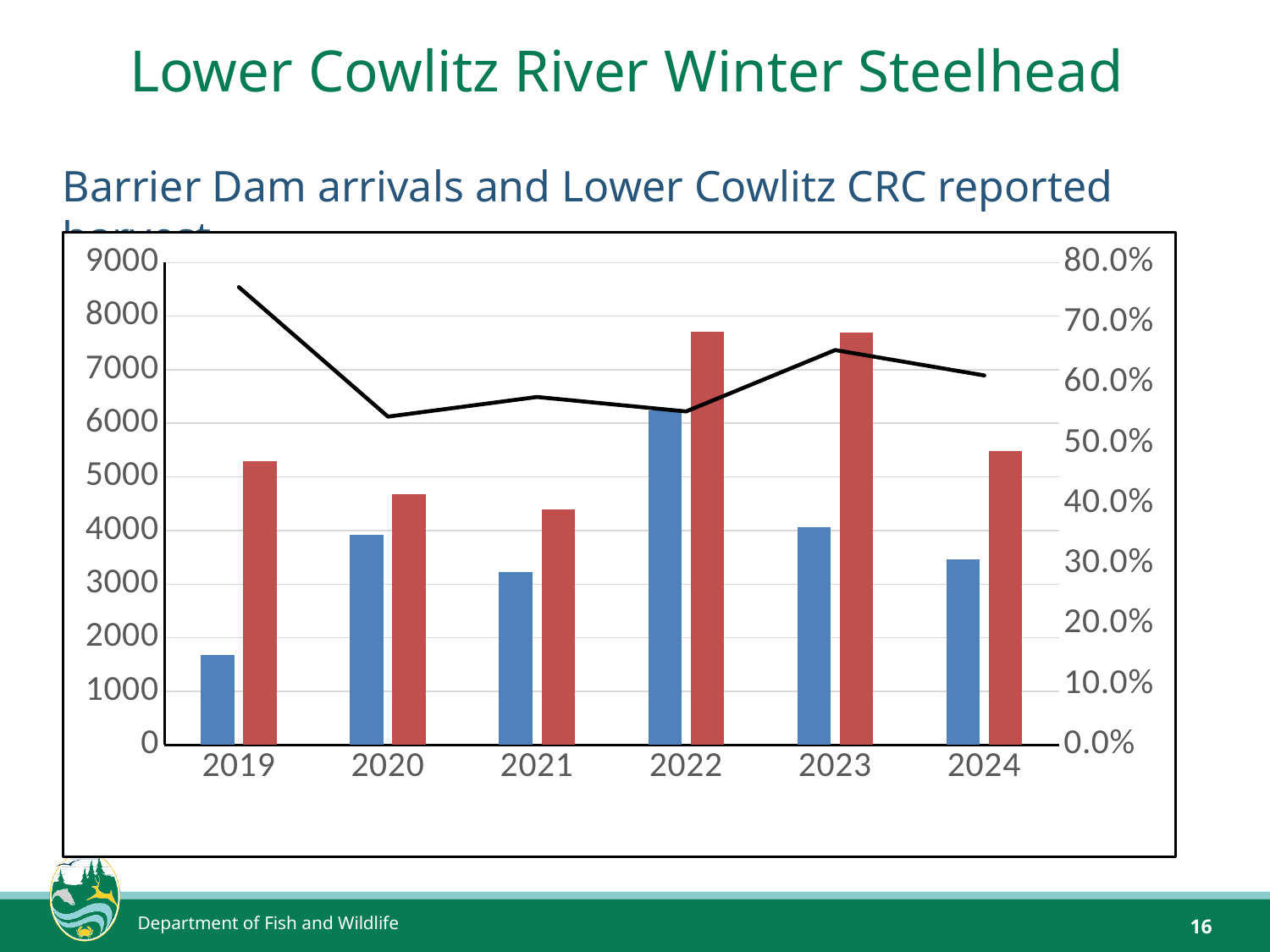
What kind of chart is shown on the slide? A bar chart with a line overlaid In which year is the blue bar the tallest? 2022 What is the highest value shown on the right-hand axis of the chart? 80.0% In which year is the blue bar the shortest? 2019 Is the value of the blue bar for 2019 greater or less than 2000? less In 2019, which bar is taller, the blue bar or the red bar? The red bar How many years are shown on the x axis of the chart? 6 Is the value of the black line for 2019 greater or less than 70.0%? greater In which year is the red bar the shortest? 2021 Is the value of the red bar for 2021 greater or less than 5000? less In which year does the black line reach its highest point? 2019